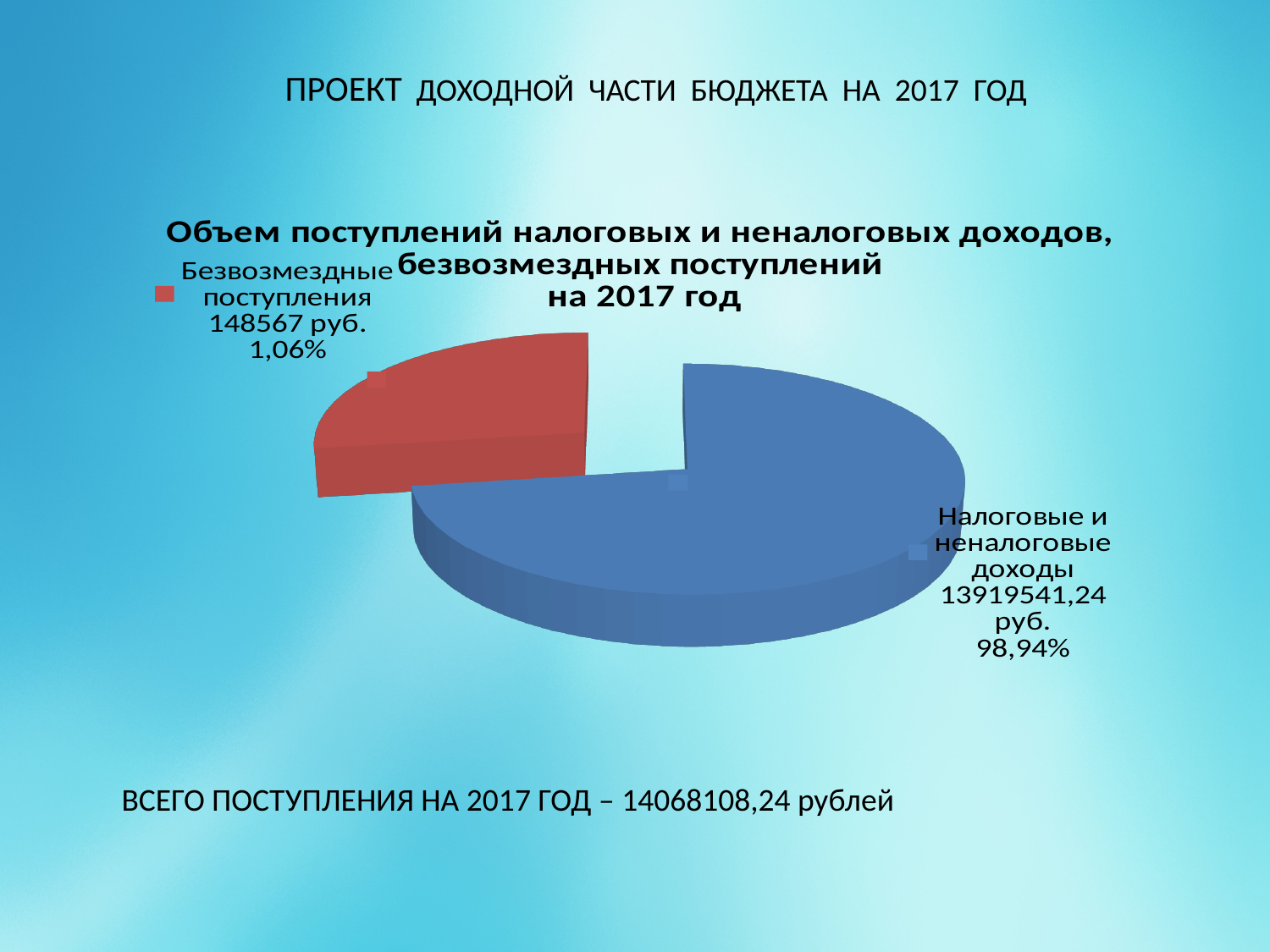
What share of the pie does "Безвозмездные поступления" represent? 1,06% Which slice of the pie chart is the largest? Налоговые и неналоговые доходы What is the difference in percentage share between "Налоговые и неналоговые доходы" and "Безвозмездные поступления"? 97,88% How many slices does the pie chart have? 2 What share of the pie does "Налоговые и неналоговые доходы" represent? 98,94% Which slice of the pie chart is the smallest? Безвозмездные поступления What colour is the slice for "Безвозмездные поступления"? red What kind of chart is shown on the slide? pie chart What is the value shown for "Безвозмездные поступления"? 148567 руб. What is the title of the pie chart? Объем поступлений налоговых и неналоговых доходов, безвозмездных поступлений на 2017 год Which is larger: "Налоговые и неналоговые доходы" or "Безвозмездные поступления"? Налоговые и неналоговые доходы What is the value shown for "Налоговые и неналоговые доходы"? 13919541,24 руб.